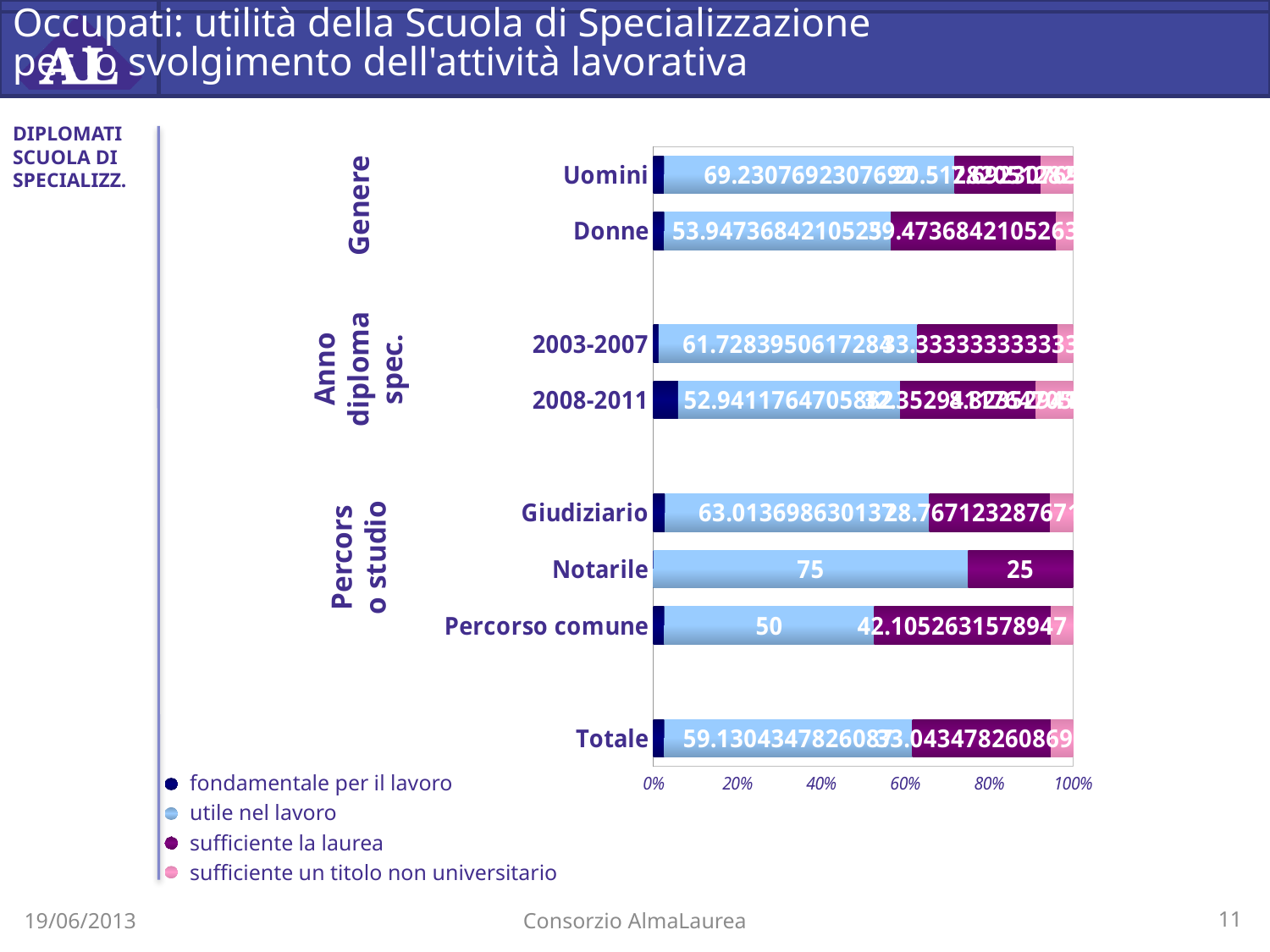
What is the value of 'sufficiente la laurea' for Percorso comune? 42.1052631578947 Which has a larger 'utile nel lavoro' value, Notarile or Percorso comune? Notarile Which category has the largest 'utile nel lavoro' segment? Notarile What is the difference between the 'utile nel lavoro' and 'sufficiente la laurea' values for Notarile? 50 What is the value of 'utile nel lavoro' for Percorso comune? 50 What type of chart is shown on the slide? bar chart How many categories (bars) are plotted in the chart? 8 What is the value of 'sufficiente la laurea' for Notarile? 25 What is the value of 'utile nel lavoro' for Notarile? 75 How many series does the legend list? 4 Is the 'utile nel lavoro' value for Donne greater or less than 60%? less Which series is shown in light blue in the legend? utile nel lavoro